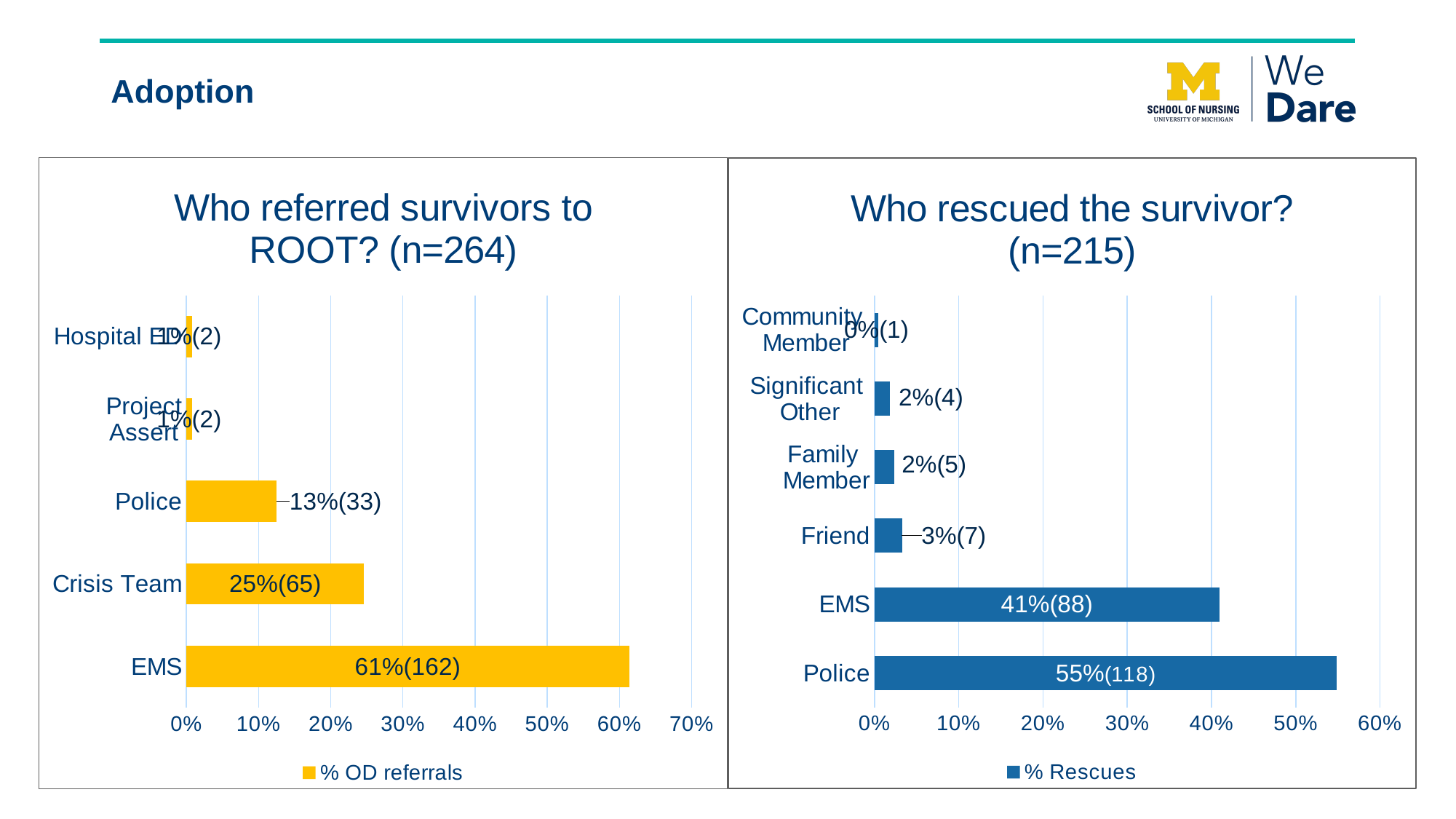
In the 'Who rescued the survivor?' chart, what is the value for Friend? 3%(7) In the 'Who rescued the survivor?' chart, which category has the lowest value? Community Member In the 'Who referred survivors to ROOT?' chart, what is the value for Police? 13%(33) In the 'Who rescued the survivor?' chart, which is larger, Police or EMS? Police In the 'Who rescued the survivor?' chart, what is the value for EMS? 41%(88) In the 'Who referred survivors to ROOT?' chart, what is the value for Crisis Team? 25%(65) What kind of chart is 'Who rescued the survivor?'? Bar chart In the 'Who referred survivors to ROOT?' chart, which category has the highest value? EMS In the 'Who referred survivors to ROOT?' chart, what is the value for EMS? 61%(162) In the 'Who rescued the survivor?' chart, what is the value for Police? 55%(118) In the 'Who referred survivors to ROOT?' chart, how many categories are shown? 5 In the 'Who referred survivors to ROOT?' chart, what is the difference in percentage points between EMS and Crisis Team? 36%